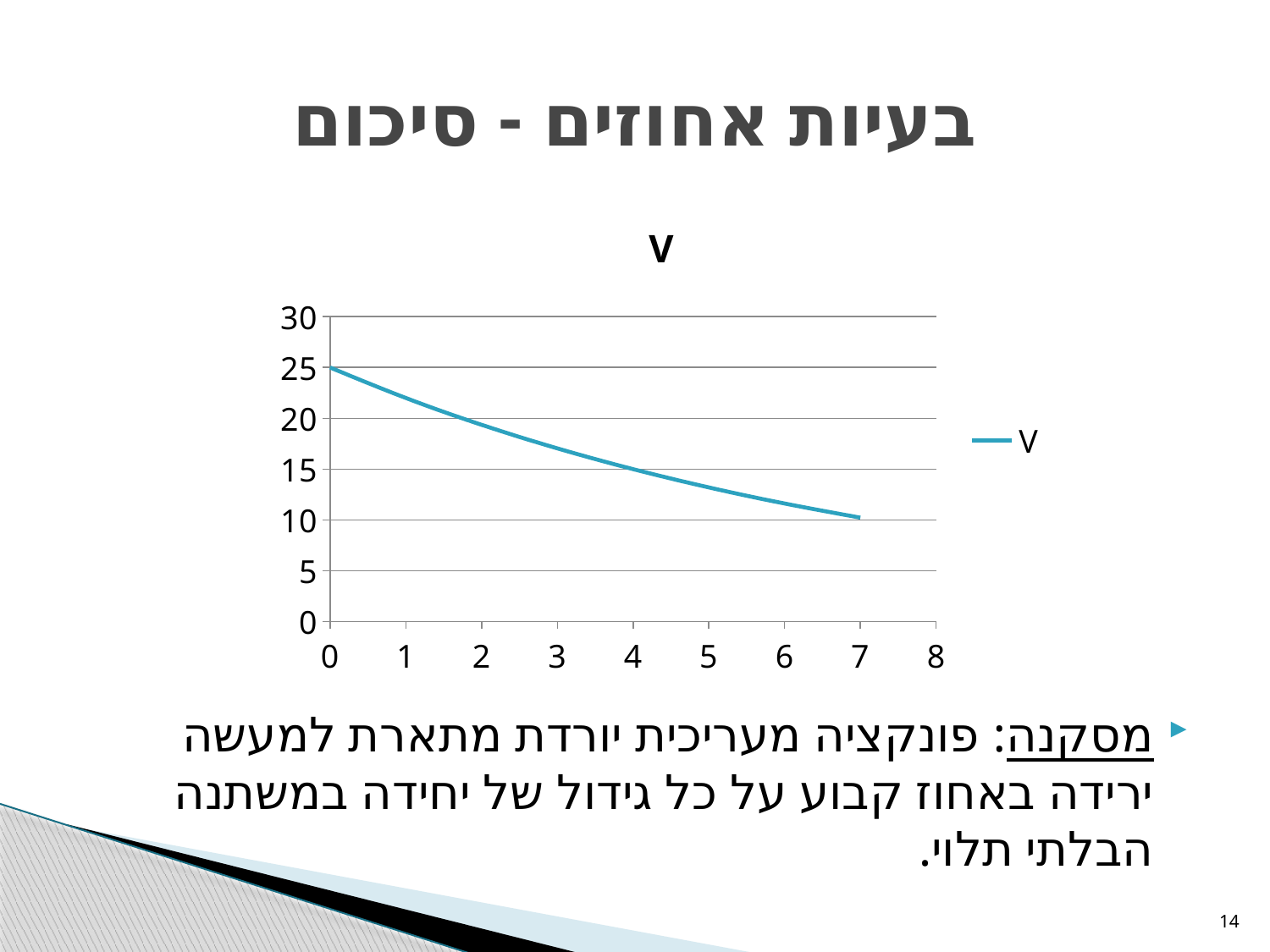
What is the value of V at x = 0? 25 Do the values of V rise or fall as x increases from 0 to 7? fall How many series does the legend list? 1 Is the value of V at x = 6 greater or less than 15? less Is the value of V at x = 1 greater or less than 20? greater What is the title of the chart? V What kind of chart is shown on the slide? line chart Which is larger, the value of V at x = 0 or at x = 7? x = 0 Is the value of V at x = 5 greater or less than 15? less What is the name of the series shown in the legend? V